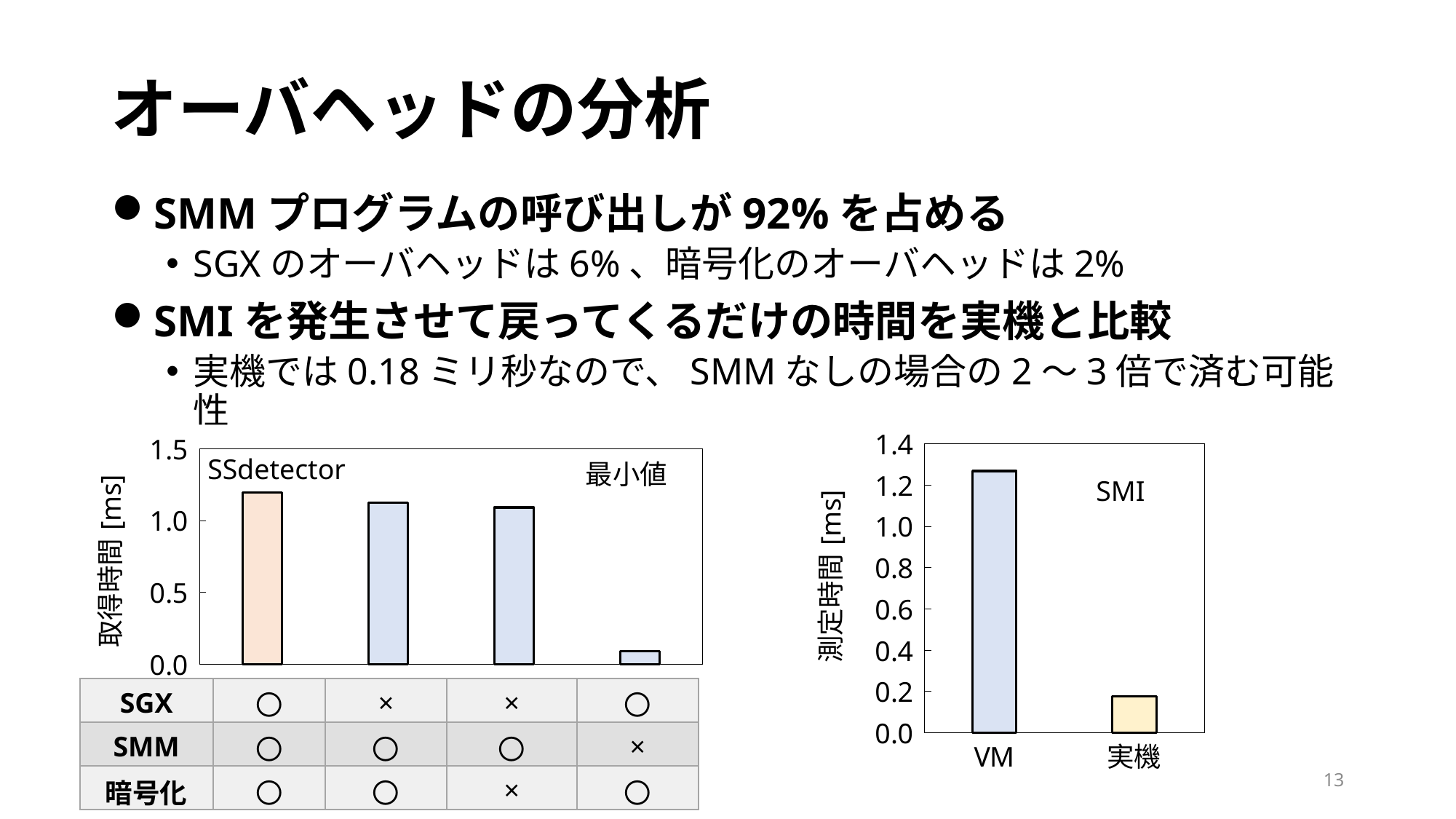
In the SMI chart, is the value for VM greater or less than 1.0? greater What is the y-axis label of the SMI chart on the right? 測定時間 [ms] In the SSdetector chart, which bar is the lowest? the fourth (rightmost) bar How many bars are plotted in the SMI chart on the right? 2 In the SMI chart, which category has the higher value, VM or 実機? VM What kind of chart is the SMI chart on the right of the slide? bar chart In the SSdetector chart, is the value of the first (leftmost) bar greater or less than 1.0? greater In the SSdetector chart, which bar is the highest? the first (leftmost) bar In the SSdetector chart, do the bar values rise or fall from left to right? fall How many bars are plotted in the SSdetector chart on the left? 4 In the SMI chart, is the value for 実機 greater or less than 0.4? less